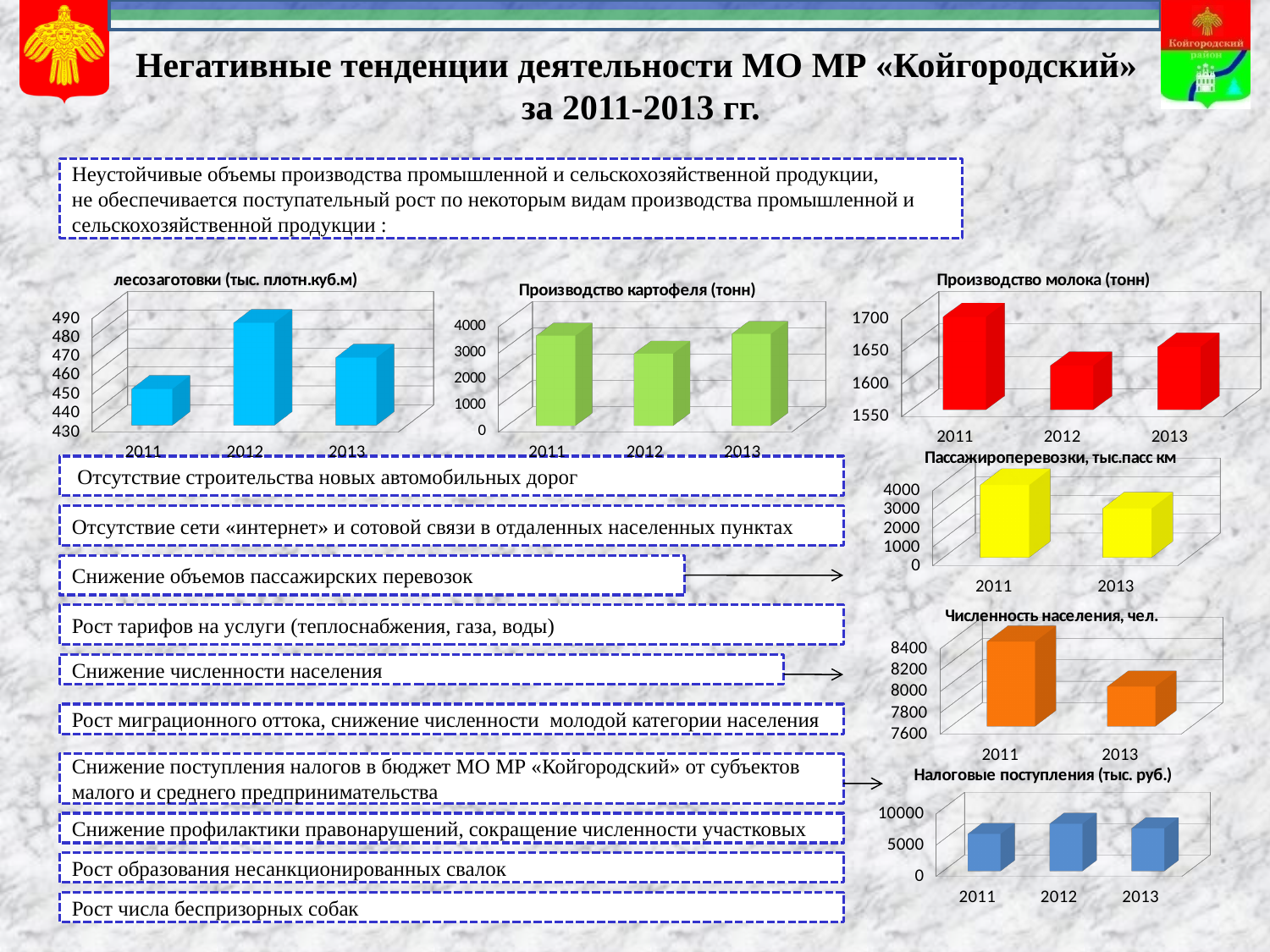
How many years are shown in the 'Численность населения, чел.' chart? 2 In the 'Численность населения, чел.' chart, is the value for 2013 greater or less than 8200? less In the 'Производство картофеля (тонн)' chart, is the value for 2012 greater or less than 3000? less What type of chart is the 'Производство молока (тонн)' chart? bar chart In the 'Производство молока (тонн)' chart, is the value for 2012 greater or less than 1650? less In the 'лесозаготовки (тыс. плотн.куб.м)' chart, which year has the lowest value? 2011 In the 'лесозаготовки (тыс. плотн.куб.м)' chart, which year has the highest value? 2012 In the 'Производство картофеля (тонн)' chart, which year has the lowest value? 2012 In the 'Пассажироперевозки, тыс.пасс км' chart, which year has the larger value, 2011 or 2013? 2011 In the 'Налоговые поступления (тыс. руб.)' chart, which year has the lowest value? 2011 In the 'Производство молока (тонн)' chart, which year has the highest value? 2011